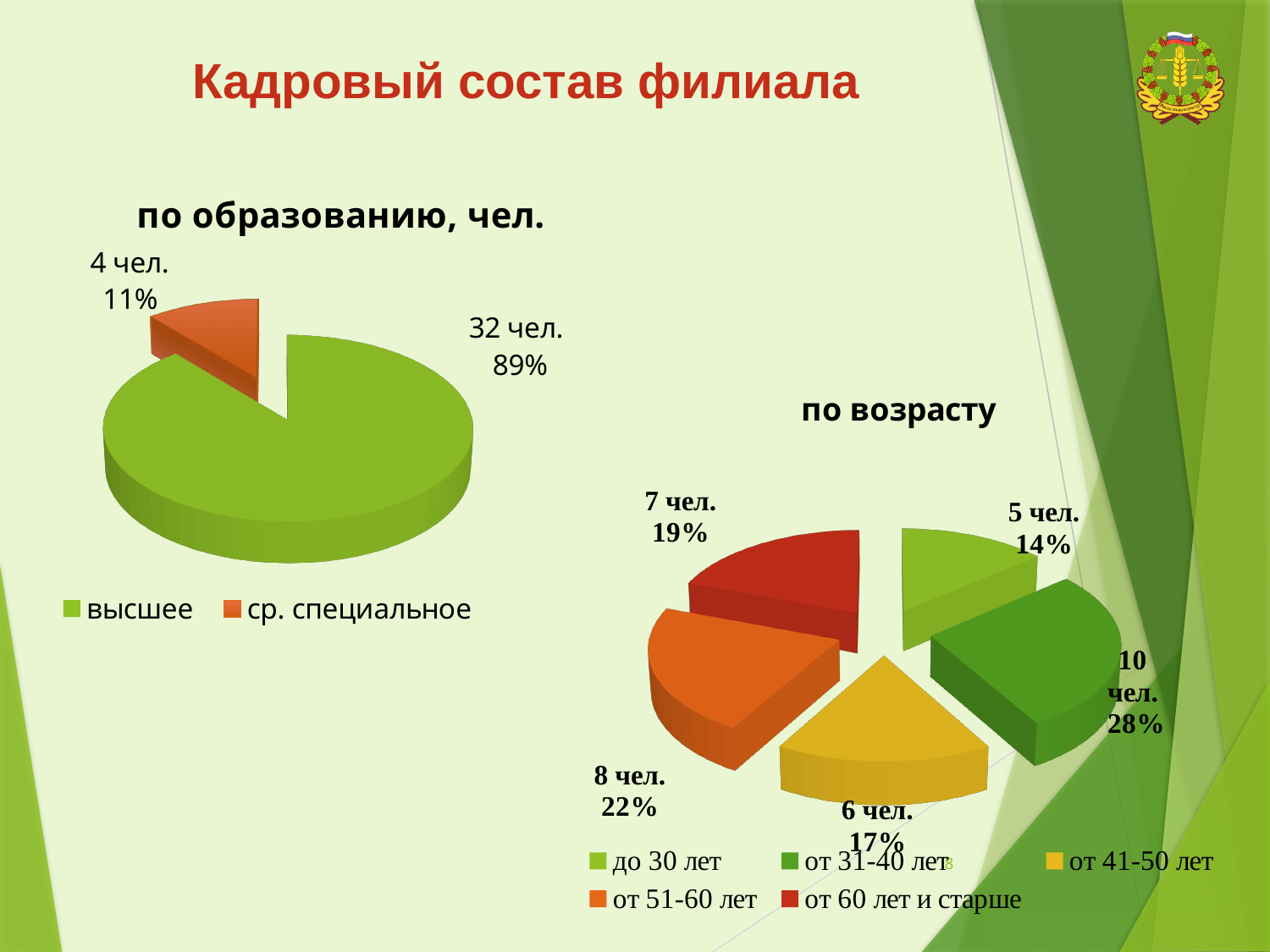
In the chart 'по возрасту', what colour is the slice for от 41-50 лет? yellow What kind of chart is 'по возрасту'? pie chart In the chart 'по образованию, чел.', what is the difference in people between высшее and ср. специальное? 28 чел. In the chart 'по образованию, чел.', how many people have высшее education? 32 чел. In the chart 'по возрасту', which age group has the most people? от 31-40 лет In the chart 'по возрасту', which age group has the fewest people? до 30 лет In the chart 'по возрасту', which group is larger: от 41-50 лет or от 60 лет и старше? от 60 лет и старше In the chart 'по возрасту', how many people are in the group от 31-40 лет? 10 чел. In the chart 'по образованию, чел.', what share of the pie is ср. специальное? 11% In the chart 'по возрасту', what share of the pie is от 51-60 лет? 22% In the chart 'по образованию, чел.', how many categories does the legend list? 2 In the chart 'по возрасту', how many age groups are shown? 5